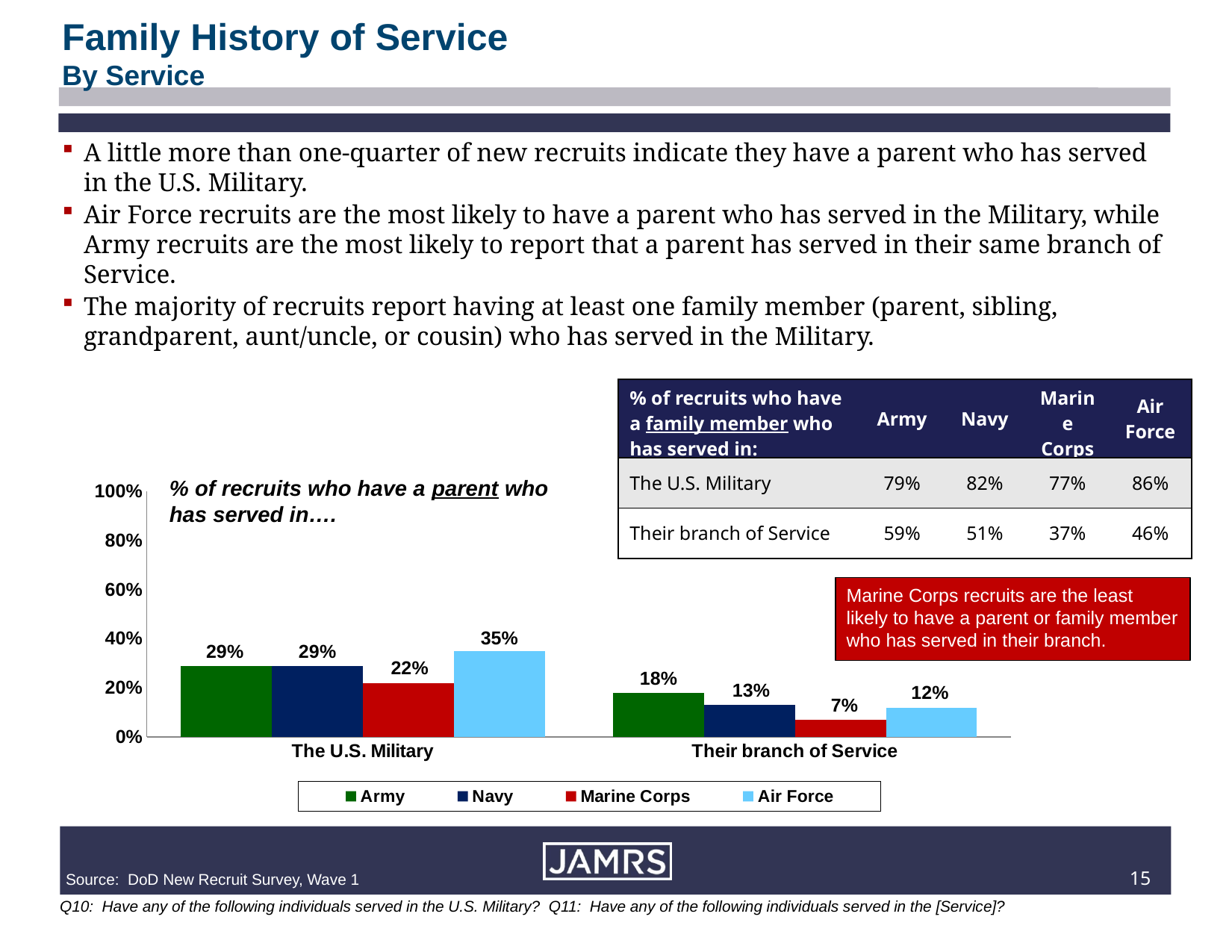
Which colour represents Marine Corps in the chart? Red What percentage of Air Force recruits have a parent who has served in the U.S. Military? 35% Is the value for Air Force recruits with a parent who served in the U.S. Military greater or less than 40%? less How many categories are shown on the x axis of the chart? 2 What kind of chart is shown on the slide? Bar chart How many series does the chart legend list? 4 Which service has the lowest percentage of recruits with a parent who has served in their branch of Service? Marine Corps What percentage of Army recruits have a parent who has served in their branch of Service? 18% Which service has the highest percentage of recruits with a parent who has served in the U.S. Military? Air Force What percentage of Marine Corps recruits have a parent who has served in their branch of Service? 7% For a parent who has served in their branch of Service, which is larger: Navy or Air Force? Navy What is the difference between the Air Force and Marine Corps percentages for a parent who has served in the U.S. Military? 13%